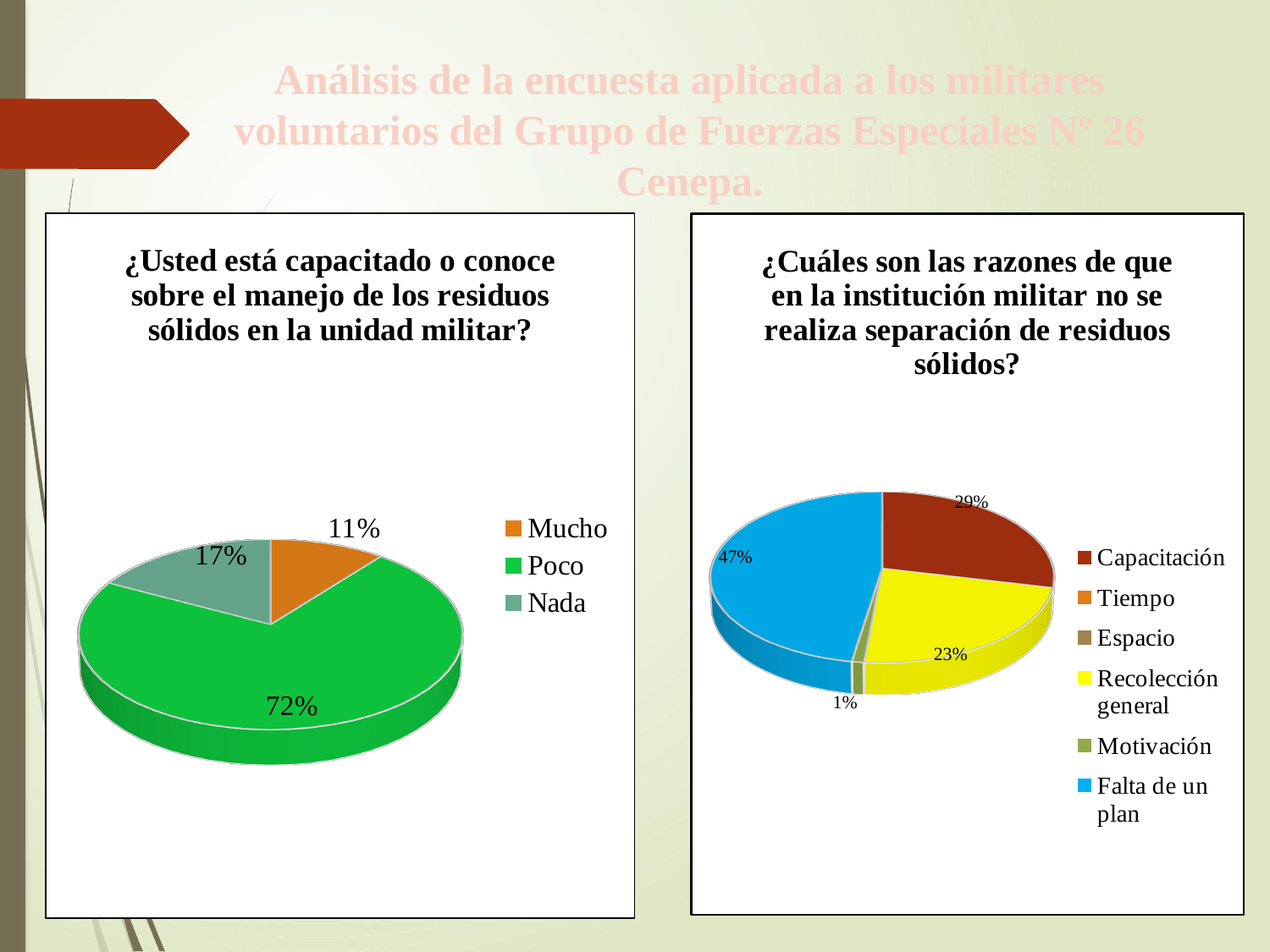
What type of chart is used on the left side of the slide? Pie chart On the left chart, what percentage of respondents answered "Nada"? 17% On the left chart, what percentage of respondents answered "Poco"? 72% On the right chart, what percentage corresponds to "Capacitación"? 29% On the left chart, which category has the smallest share? Mucho On the left chart, which category has the largest share? Poco On the right chart, what percentage corresponds to "Recolección general"? 23% On the right chart, what percentage corresponds to "Falta de un plan"? 47% On the right chart, which is larger, "Capacitación" or "Recolección general"? Capacitación How many entries does the legend of the right chart list? 6 On the left chart, what percentage of respondents answered "Mucho"? 11% On the left chart, what is the difference in percentage points between "Poco" and "Nada"? 55